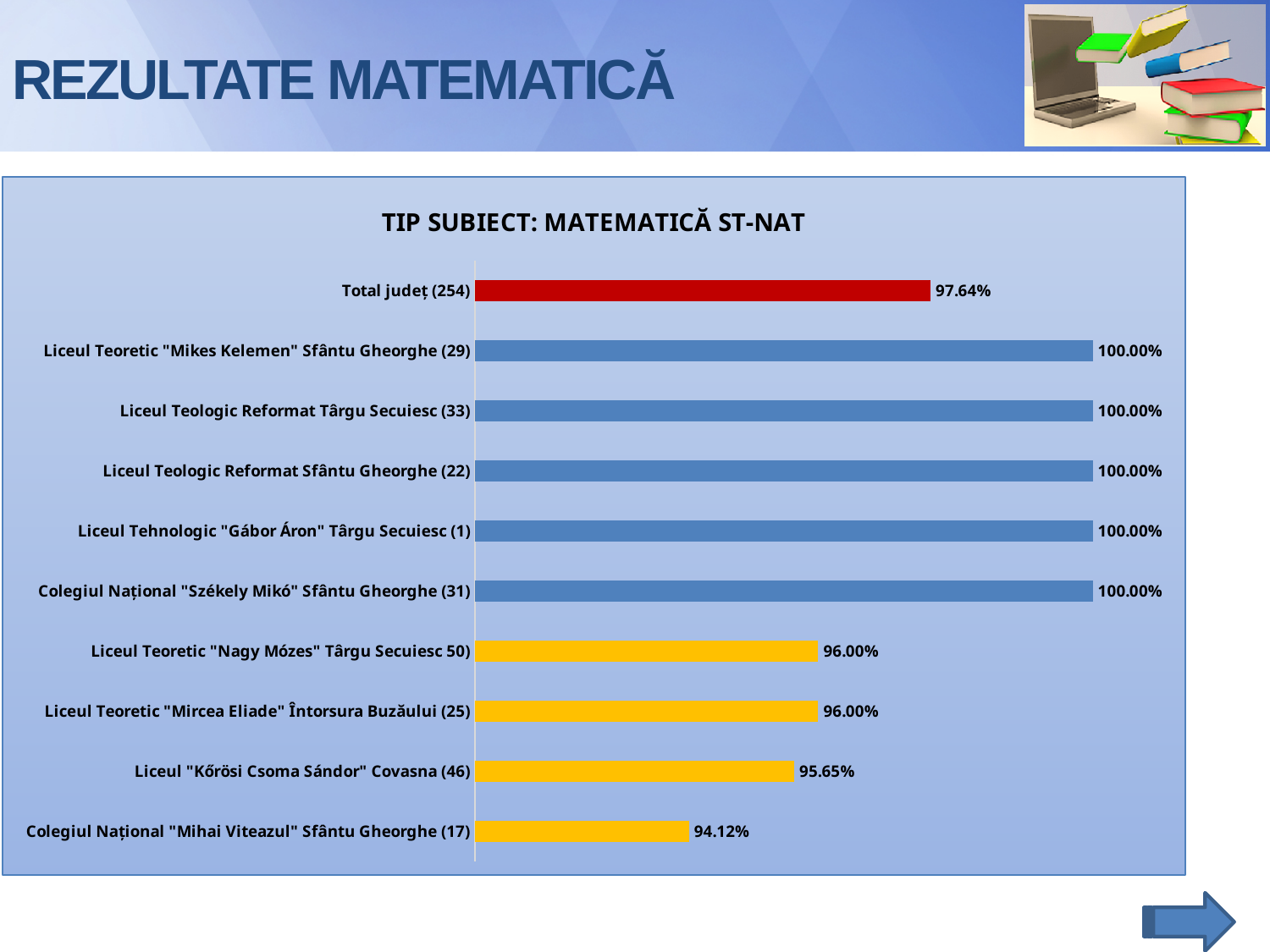
What is the value for Liceul "Kőrösi Csoma Sándor" Covasna (46)? 95.65% What kind of chart is shown on the slide? bar chart What is the value for Liceul Teoretic "Nagy Mózes" Târgu Secuiesc 50)? 96.00% How many categories are shown in the chart? 10 Which category has the lowest value? Colegiul Național "Mihai Viteazul" Sfântu Gheorghe (17) What is the difference between the value for Liceul Teoretic "Mikes Kelemen" Sfântu Gheorghe (29) and the value for Liceul "Kőrösi Csoma Sándor" Covasna (46)? 4.35% What is the title of the chart? TIP SUBIECT: MATEMATICĂ ST-NAT What is the difference between the value for Total județ (254) and the value for Colegiul Național "Mihai Viteazul" Sfântu Gheorghe (17)? 3.52% Which is larger: the value for Liceul Teoretic "Mircea Eliade" Întorsura Buzăului (25) or the value for Liceul "Kőrösi Csoma Sándor" Covasna (46)? Liceul Teoretic "Mircea Eliade" Întorsura Buzăului (25) How many categories have a value of 100.00%? 5 What is the value for Total județ (254)? 97.64% What is the value for Colegiul Național "Mihai Viteazul" Sfântu Gheorghe (17)? 94.12%